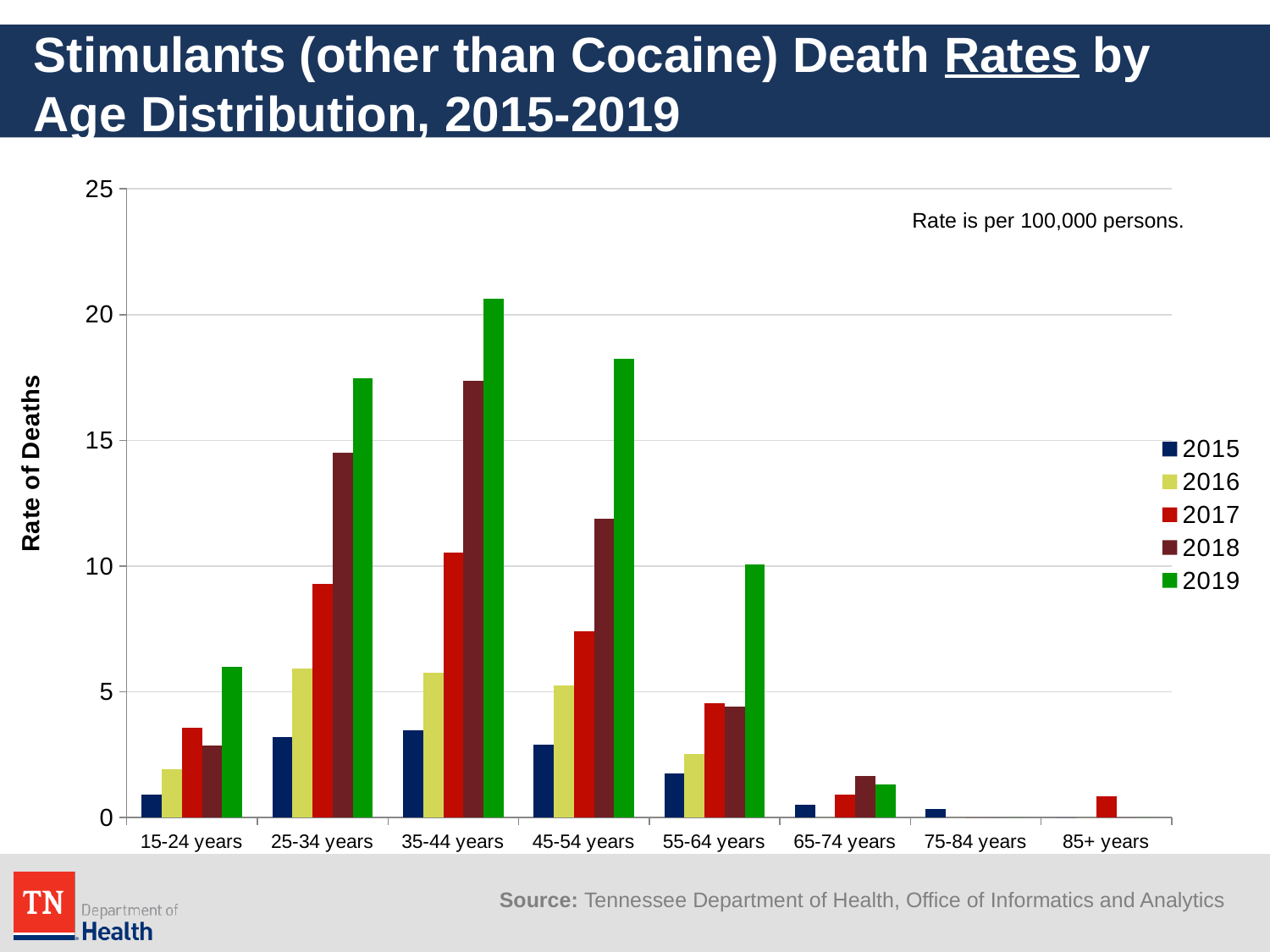
Is the 2019 value for 45-54 years greater or less than 15? greater What kind of chart is shown on the slide? Bar chart For 45-54 years, which is larger: the 2016 rate or the 2017 rate? 2017 For 2018, which is larger: the rate for 35-44 years or the rate for 45-54 years? 35-44 years Which year has the lowest death rate in the 15-24 years group? 2015 Is the 2019 value for 15-24 years greater or less than 5? greater Is the 2017 value for 25-34 years greater or less than 10? less For the 35-44 years group, do the rates rise or fall from 2015 to 2019? Rise What is the label on the y axis? Rate of Deaths How many age groups are shown on the x axis? 8 How many series (years) does the legend list? 5 Which age group has the highest death rate for 2019? 35-44 years